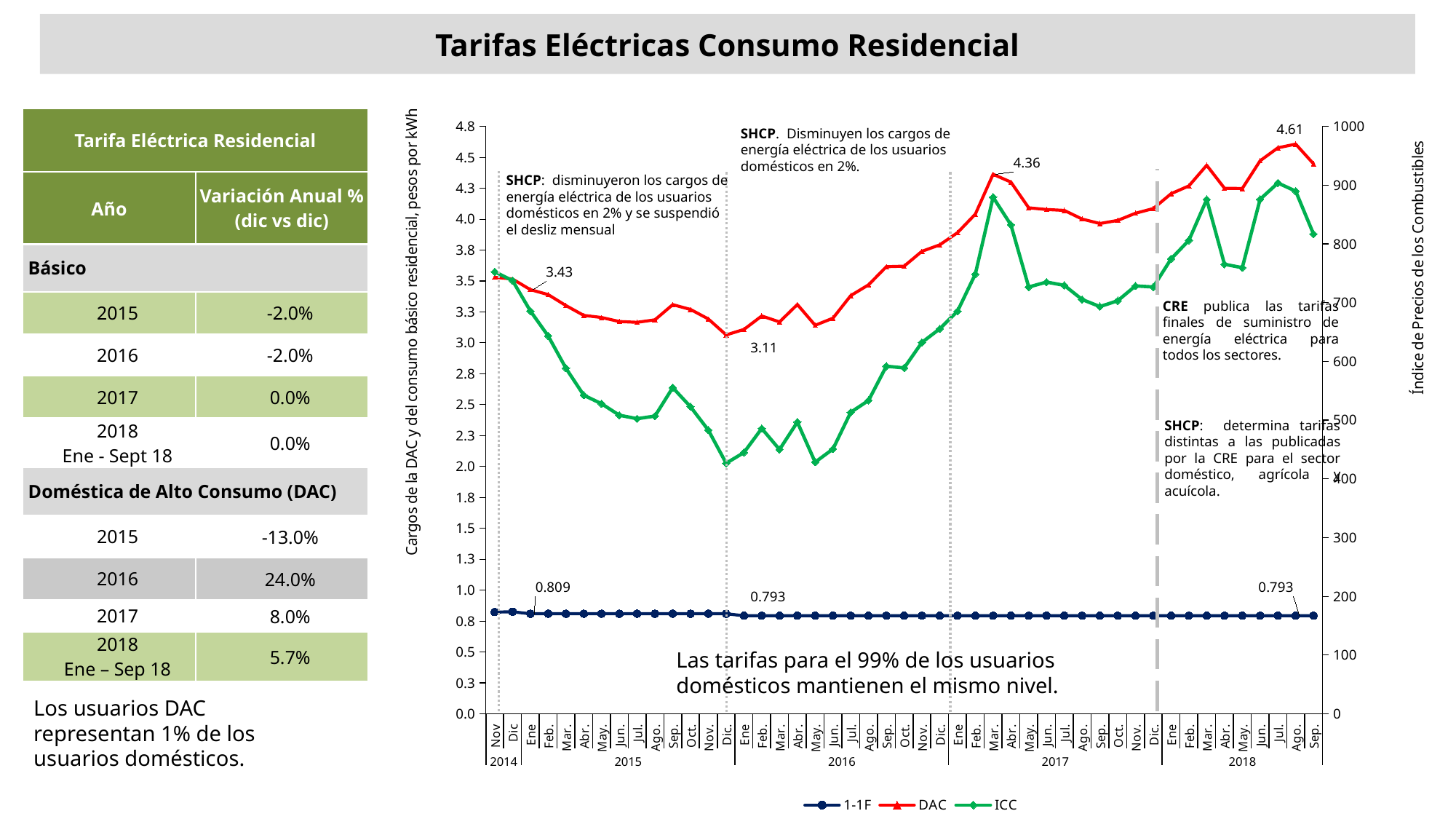
Which series has the lowest values across the whole chart? 1-1F What value is labeled on the DAC line at Mar 2017? 4.36 What value is labeled on the 1-1F line at Sep 2018? 0.793 How many series does the chart legend list? 3 What is the difference between the DAC labeled values 4.61 and 3.11? 1.50 What kind of chart is shown on the slide? line chart What is the highest labeled value on the DAC line? 4.61 Does the ICC line rise or fall from Nov 2014 to Dic 2015? fall